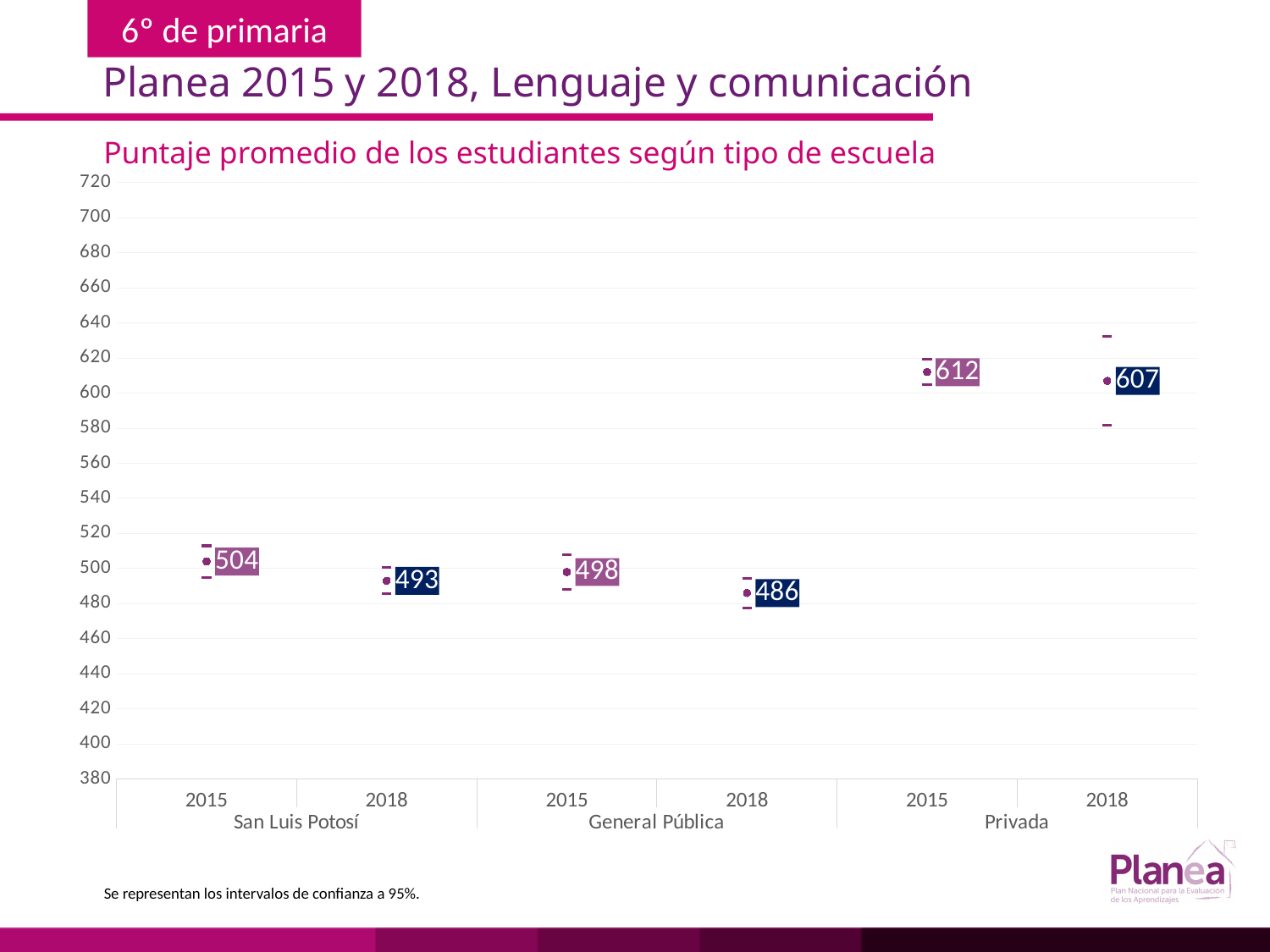
Did the score for General Pública rise or fall from 2015 to 2018? fall Which is larger, the 2018 score for San Luis Potosí or the 2018 score for General Pública? San Luis Potosí 2018 What is the difference between the San Luis Potosí scores in 2015 and 2018? 11 What is the average score for General Pública in 2018? 486 Which school type and year has the lowest average score? General Pública 2018 What is the title of the chart? Puntaje promedio de los estudiantes según tipo de escuela Which school type and year has the highest average score? Privada 2015 What is the average score for San Luis Potosí in 2015? 504 How many data points are plotted on the chart? 6 What is the average score for Privada in 2015? 612 Is the 2018 score for Privada greater or less than 600? greater What is the difference between the Privada scores in 2015 and 2018? 5